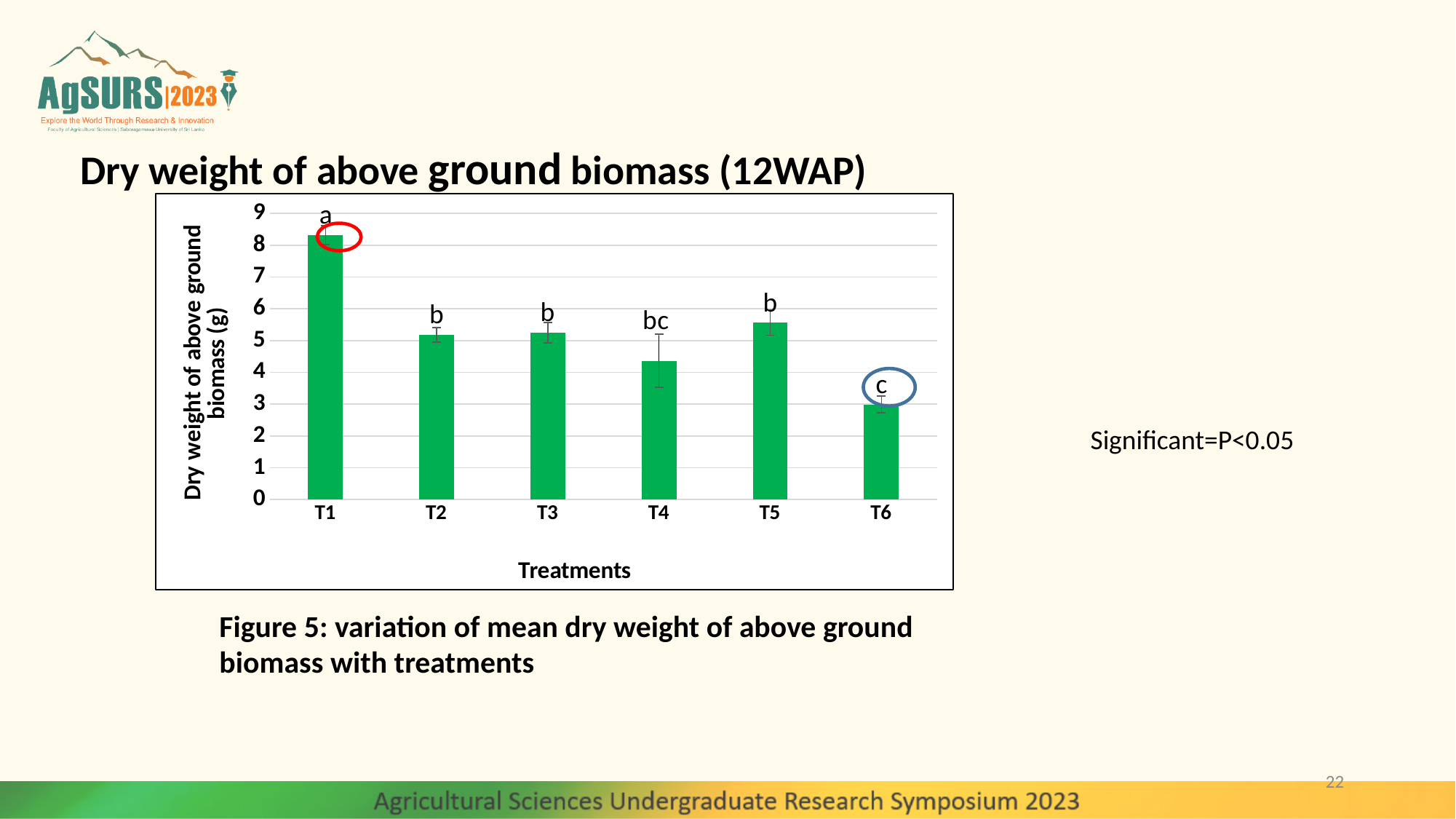
Is the value for T4 greater or less than 5? less Which has the larger dry weight of above ground biomass, T1 or T5? T1 What significance letter is printed above the T4 bar? bc Is the value for T5 greater or less than 5? greater Is the value for T6 greater or less than 4? less What kind of chart is shown on the slide? bar chart What is the title of the y axis of the chart? Dry weight of above ground biomass (g) Which treatment has the lowest dry weight of above ground biomass? T6 How many treatments are plotted on the x axis of the chart? 6 Which has the larger dry weight of above ground biomass, T4 or T6? T4 Which treatment has the highest dry weight of above ground biomass? T1